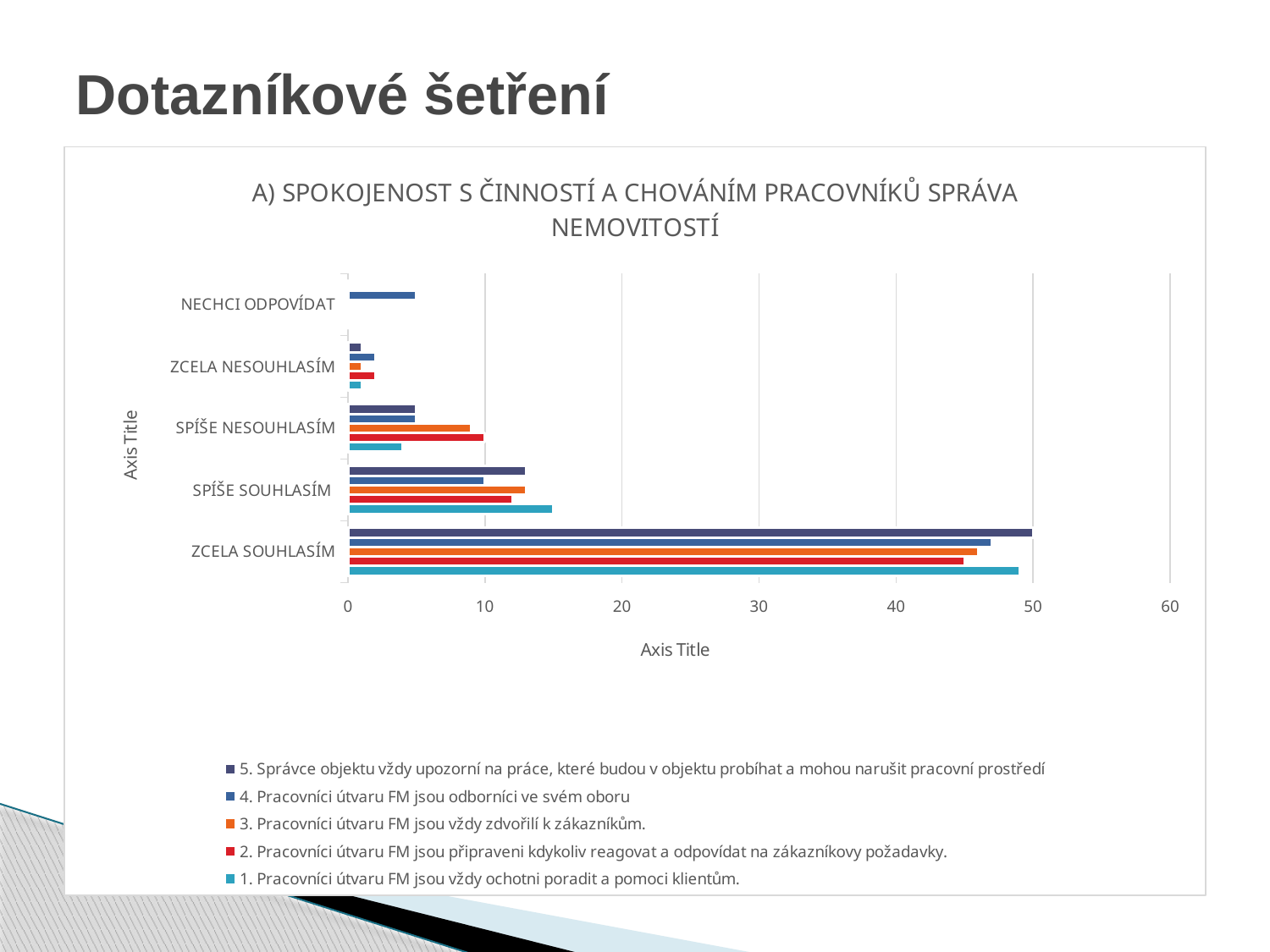
For SPÍŠE NESOUHLASÍM, which is larger: the value for series 2 (Pracovníci útvaru FM jsou připraveni kdykoliv reagovat...) or series 1 (Pracovníci útvaru FM jsou vždy ochotni poradit...)? series 2 What kind of chart is shown on the slide? bar chart Is the value for SPÍŠE SOUHLASÍM in series 5 (Správce objektu vždy upozorní na práce...) greater or less than 10? greater For series 5 (Správce objektu vždy upozorní na práce...), which category has the lowest value? NECHCI ODPOVÍDAT For ZCELA SOUHLASÍM, which is larger: the value for series 5 (Správce objektu vždy upozorní...) or series 2 (Pracovníci útvaru FM jsou připraveni kdykoliv reagovat...)? series 5 Is the value for NECHCI ODPOVÍDAT in series 5 greater or less than 10? less How many categories are shown on the vertical axis of the chart? 5 What is the title of the chart? A) SPOKOJENOST S ČINNOSTÍ A CHOVÁNÍM PRACOVNÍKŮ SPRÁVA NEMOVITOSTÍ Is the value for ZCELA SOUHLASÍM in series 3 (Pracovníci útvaru FM jsou vždy zdvořilí k zákazníkům) greater or less than 40? greater How many series does the chart's legend list? 5 Which category has the highest values across the series? ZCELA SOUHLASÍM